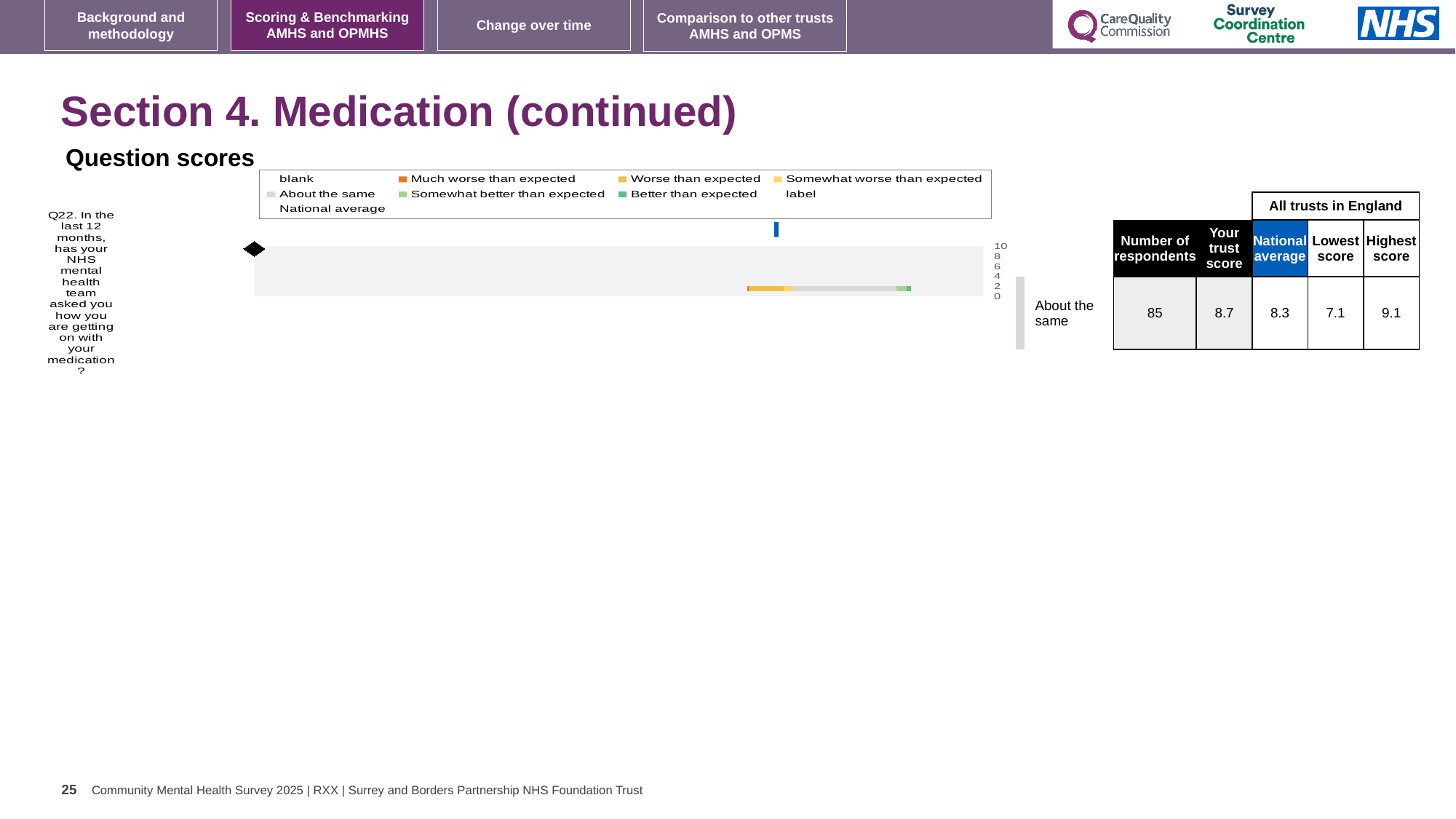
In the table beside the Question scores chart, what is the highest score among all trusts in England for Q22? 9.1 In the table beside the Question scores chart, which is larger for Q22: your trust score or the national average? Your trust score Which question is plotted in the Question scores chart? Q22. In the last 12 months, has your NHS mental health team asked you how you are getting on with your medication? How many question categories are plotted in the Question scores chart? 1 What is the highest tick value shown on the axis of the Question scores chart? 10 What kind of chart is shown under 'Question scores'? bar chart In the table beside the Question scores chart, what is your trust score for Q22? 8.7 In the table beside the Question scores chart, what is the number of respondents for Q22? 85 In the table beside the Question scores chart, what is the national average for Q22? 8.3 In the table beside the Question scores chart, what is the difference between the highest score and the lowest score for Q22? 2.0 What comparison category is shown next to the Question scores chart for Q22? About the same How many entries does the legend of the Question scores chart list? 9